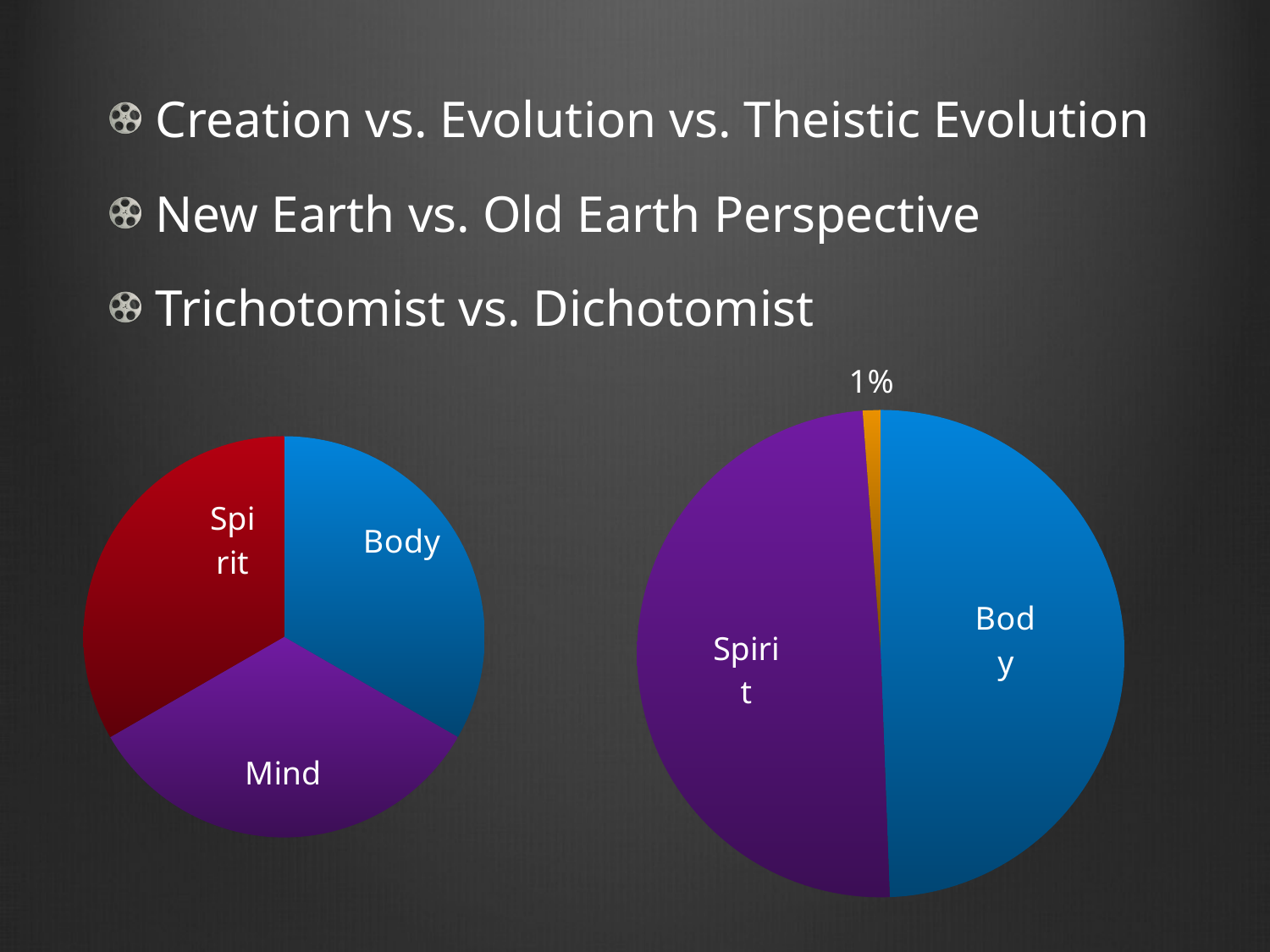
In the right pie chart, which is larger, the Spirit slice or the slice labelled 1%? Spirit In the right pie chart, what percentage is printed on the small orange slice? 1% How many slices does the left pie chart have? 3 What kind of chart is the left chart on the slide? pie chart In the right pie chart, which is larger, the Body slice or the slice labelled 1%? Body In the right pie chart, what is the share of the smallest slice? 1% How many slices does the right pie chart have? 3 What are the labels of the three slices in the left pie chart? Body, Mind, Spirit What kind of chart is the right chart on the slide? pie chart In the left pie chart, what colour is the Spirit slice? red